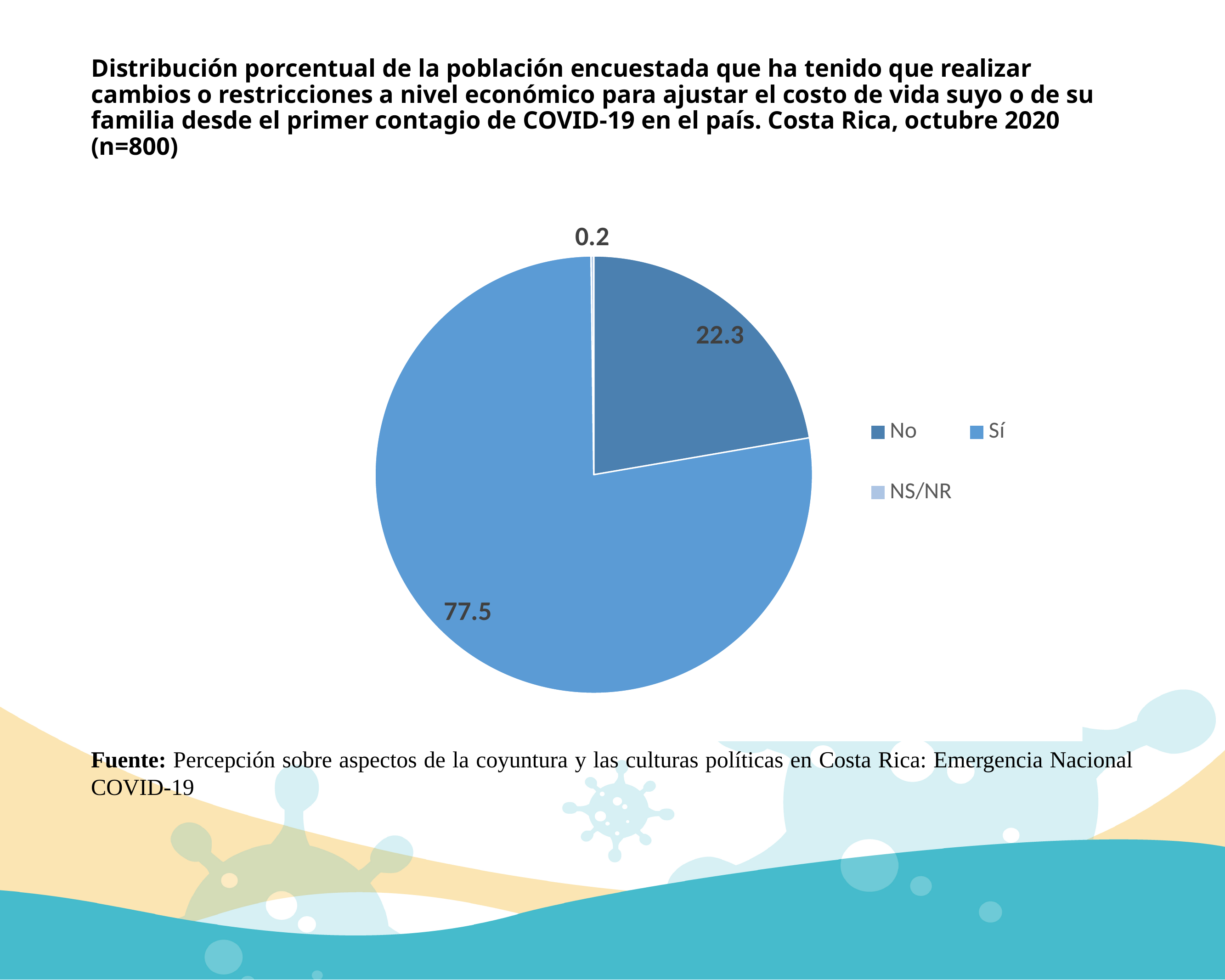
What is the sample size (n) stated in the chart title? 800 What is the value for the "Sí" slice? 77.5 What is the value for the "No" slice? 22.3 Which is larger, the "No" slice or the "NS/NR" slice? No Which legend entry is shown in the lightest blue colour? NS/NR How many categories does the pie chart show? 3 What type of chart is shown on the slide? pie chart How many entries does the legend list? 3 Which category has the largest slice? Sí Which category has the smallest slice? NS/NR What is the difference between the "Sí" and "No" values? 55.2 What is the value for the "NS/NR" slice? 0.2